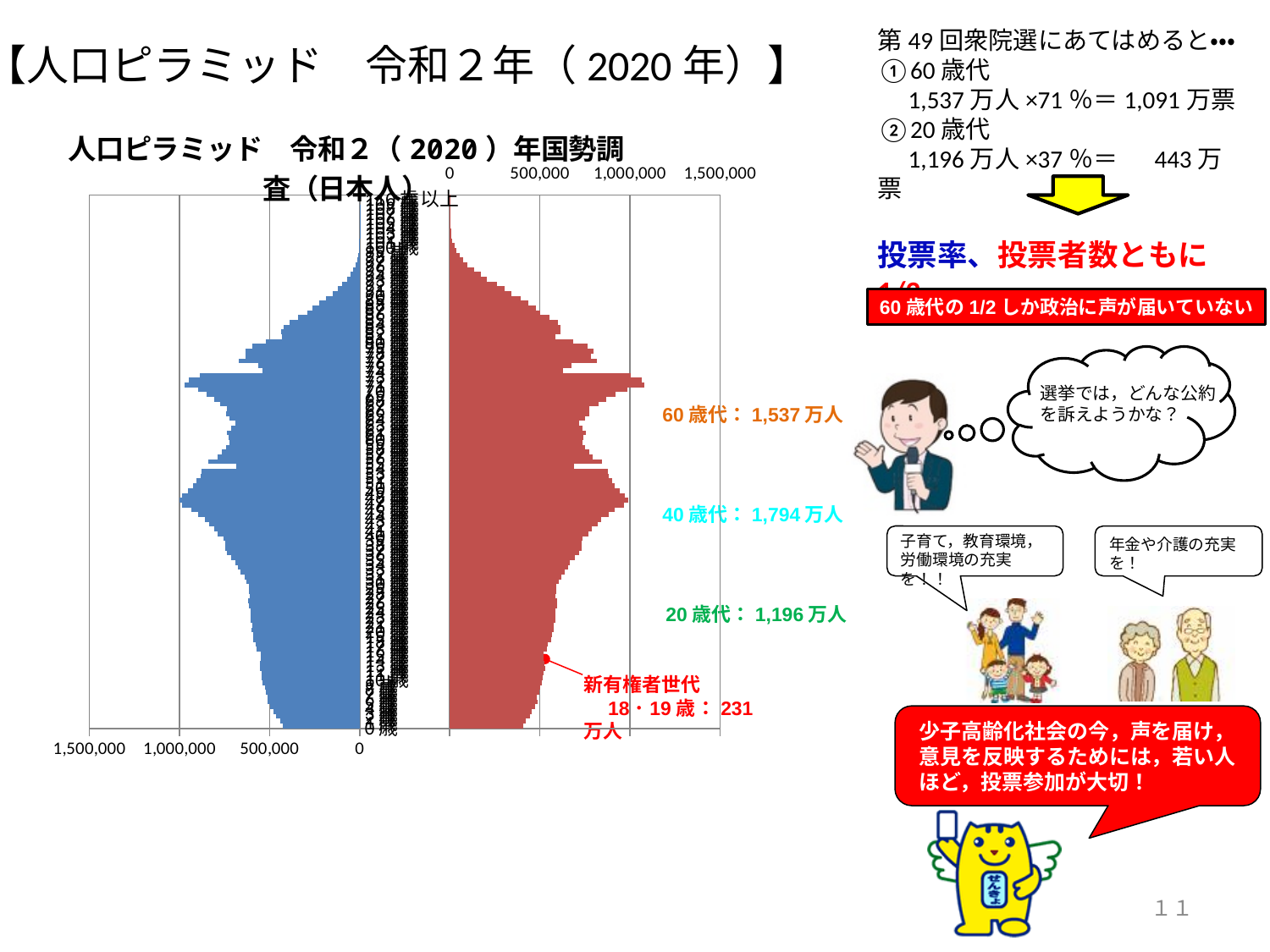
Of the three age groups annotated on the chart (20歳代, 40歳代, 60歳代), which has the smallest population? 20歳代 According to the annotation on the chart, what is the population of the 20歳代 group? 1,196万人 What is the difference between the annotated populations of the 40歳代 and 20歳代 groups? 598万人 What is the highest value shown on the horizontal axis of the chart? 1,500,000 According to the annotation on the chart, what is the population of the 40歳代 group? 1,794万人 Is the longest red bar in the chart greater or less than 1,500,000? less What is the title of the chart? 人口ピラミッド 令和2（2020）年国勢調査（日本人） Which annotated group has the larger population, 60歳代 or 20歳代? 60歳代 Of the three age groups annotated on the chart (20歳代, 40歳代, 60歳代), which has the largest population? 40歳代 What kind of chart is shown on the slide? bar chart (population pyramid) According to the annotation on the chart, what is the population of the 60歳代 group? 1,537万人 What population is given for the 新有権者世代 (18・19歳) on the chart? 231万人